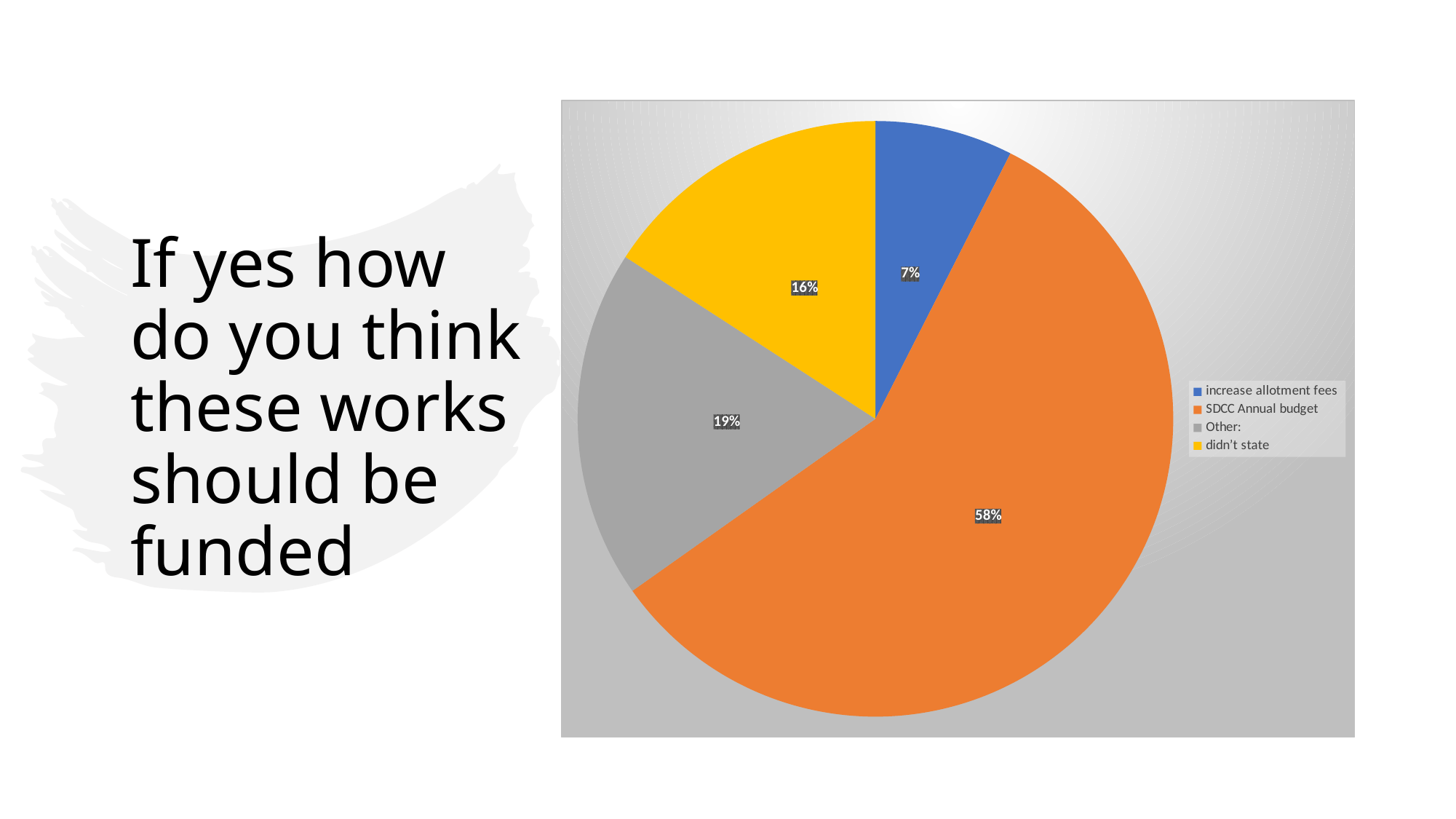
Which is larger, the slice for "didn't state" or the slice for "increase allotment fees"? didn't state What share of the pie does "SDCC Annual budget" have? 58% Which category has the largest slice of the pie? SDCC Annual budget Which category has the smallest slice of the pie? increase allotment fees What share of the pie does "didn't state" have? 16% What is the difference in percentage points between "SDCC Annual budget" and "Other:"? 39 What share of the pie does "increase allotment fees" have? 7% How many slices does the pie chart have? 4 What kind of chart is shown on the slide? pie chart What is the difference in percentage points between "Other:" and "didn't state"? 3 What colour is the slice for "SDCC Annual budget"? orange